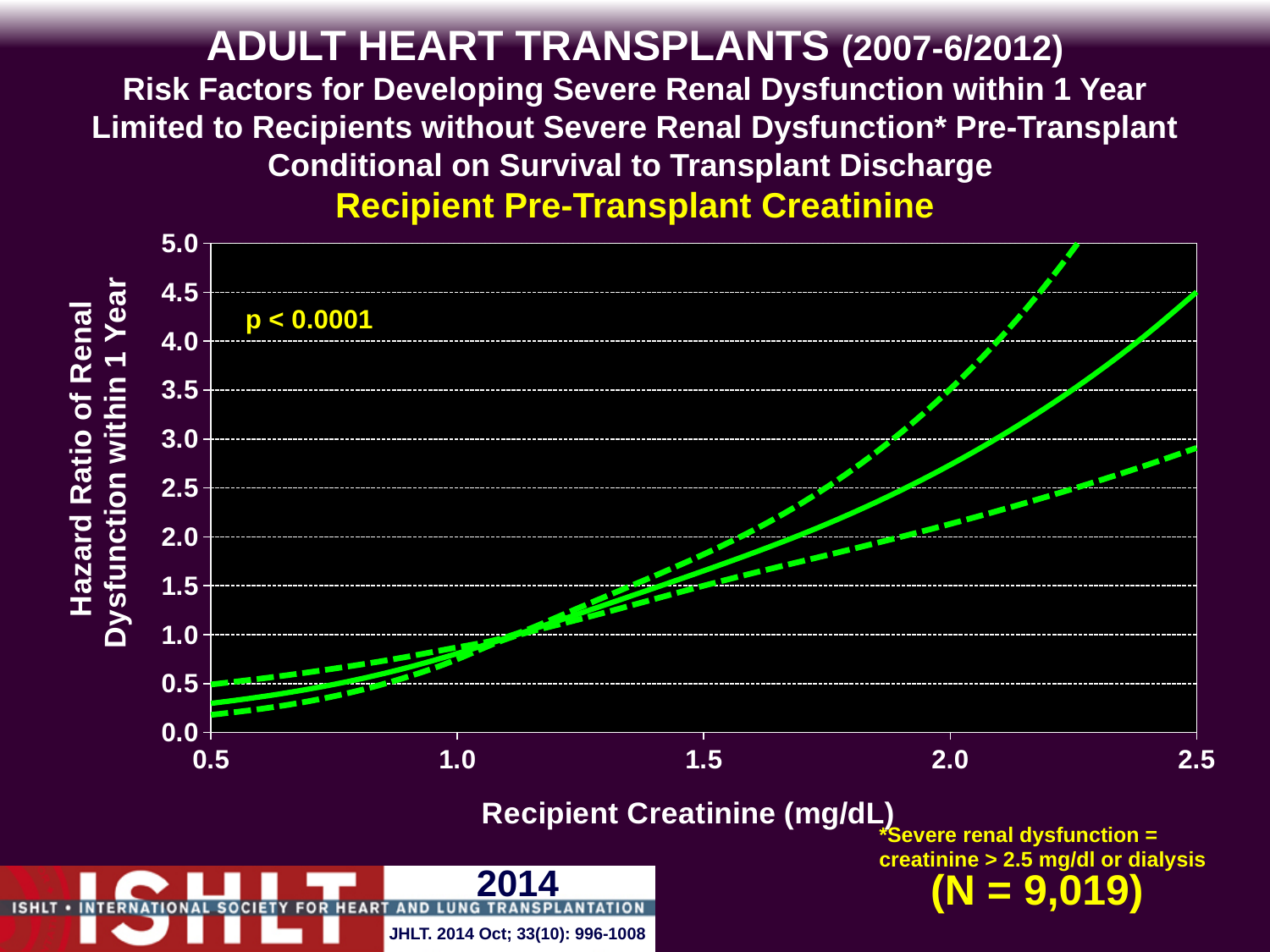
How many lines are plotted on the chart? 3 Is the hazard ratio (solid line) at a recipient creatinine of 2.5 mg/dL greater or less than 4.0? greater Does the solid hazard ratio line rise or fall as recipient creatinine increases from 0.5 to 2.5 mg/dL? rise Is the hazard ratio (solid line) at a recipient creatinine of 0.5 mg/dL greater or less than 0.5? less Is the hazard ratio (solid line) at a recipient creatinine of 1.5 mg/dL greater or less than 1.0? greater What is the highest value shown on the y axis of the chart? 5.0 What p-value is printed on the chart? p < 0.0001 What kind of chart is shown on the slide? line chart